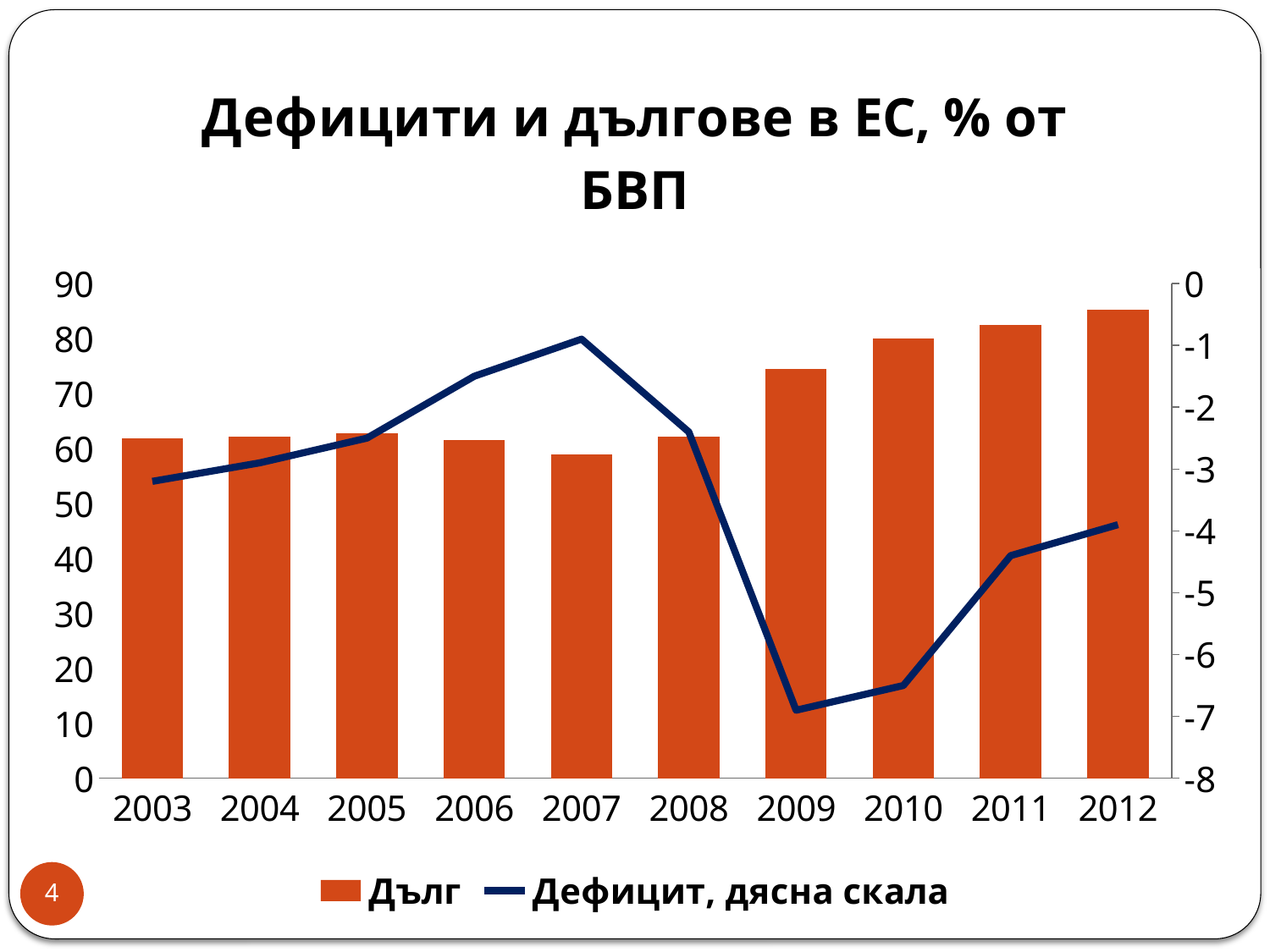
What is the title of the chart? Дефицити и дългове в ЕС, % от БВП Do the Дълг bars rise or fall from 2009 to 2012? rise Which is larger, the Дълг value for 2010 or for 2006? 2010 Is the value for Дълг in 2009 greater or less than 70? greater In which year does the Дефицит line reach its lowest point? 2009 Which year has the highest value for Дълг? 2012 What kind of chart is shown on the slide? bar chart with a line Which year has the lowest value for Дълг? 2007 Is the value for Дефицит in 2009 greater or less than -6 on the right scale? less How many series does the legend list? 2 How many years are shown on the x axis? 10